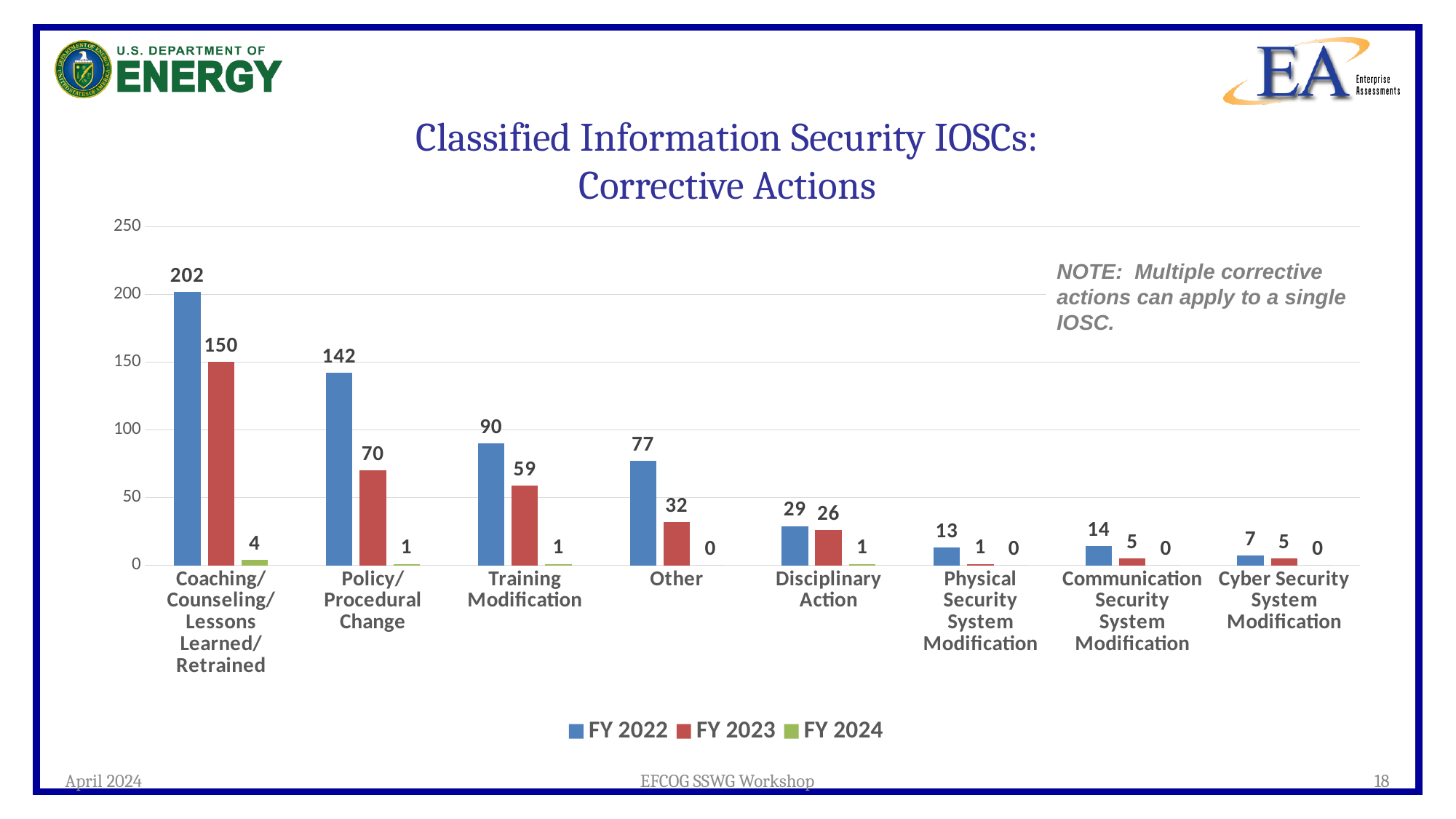
What is the title of the chart? Classified Information Security IOSCs: Corrective Actions How many series does the legend list? 3 What kind of chart is shown on the slide? Bar chart Which category has the highest FY 2022 value? Coaching/Counseling/Lessons Learned/Retrained Which category has the lowest FY 2023 value? Physical Security System Modification What is the FY 2022 value for Coaching/Counseling/Lessons Learned/Retrained? 202 How many categories are shown on the x axis? 8 What is the FY 2024 value for Coaching/Counseling/Lessons Learned/Retrained? 4 What is the FY 2023 value for Other? 32 Which is larger for Disciplinary Action: the FY 2022 value or the FY 2023 value? FY 2022 What is the FY 2023 value for Policy/Procedural Change? 70 What is the difference between the FY 2022 and FY 2023 values for Training Modification? 31